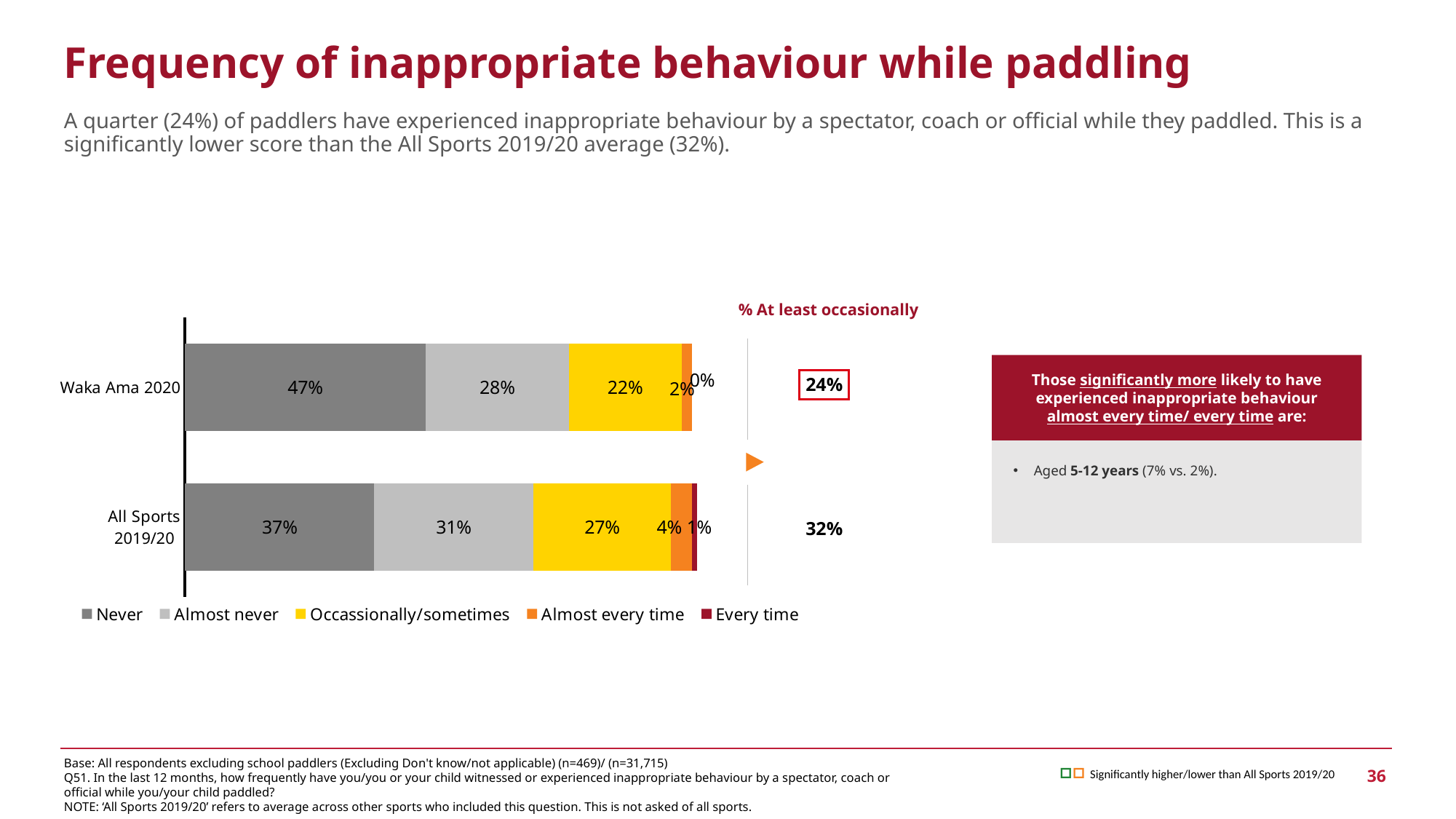
Which colour represents 'Almost every time' in the chart legend? Orange What is the difference between the '% At least occasionally' figures for All Sports 2019/20 and Waka Ama 2020? 8% What is the 'Almost never' value for Waka Ama 2020? 28% What type of chart is shown on the slide? Stacked bar chart What is the 'Occasionally/sometimes' value for All Sports 2019/20? 27% How many series does the chart legend list? 5 Which category has the higher 'Never' value, Waka Ama 2020 or All Sports 2019/20? Waka Ama 2020 How many categories (bars) are shown in the chart? 2 What is the 'Every time' value for All Sports 2019/20? 1% What is the difference between the 'Occasionally/sometimes' values for All Sports 2019/20 and Waka Ama 2020? 5% What percentage of Waka Ama 2020 respondents answered 'Never'? 47% What is the '% At least occasionally' figure shown for Waka Ama 2020? 24%